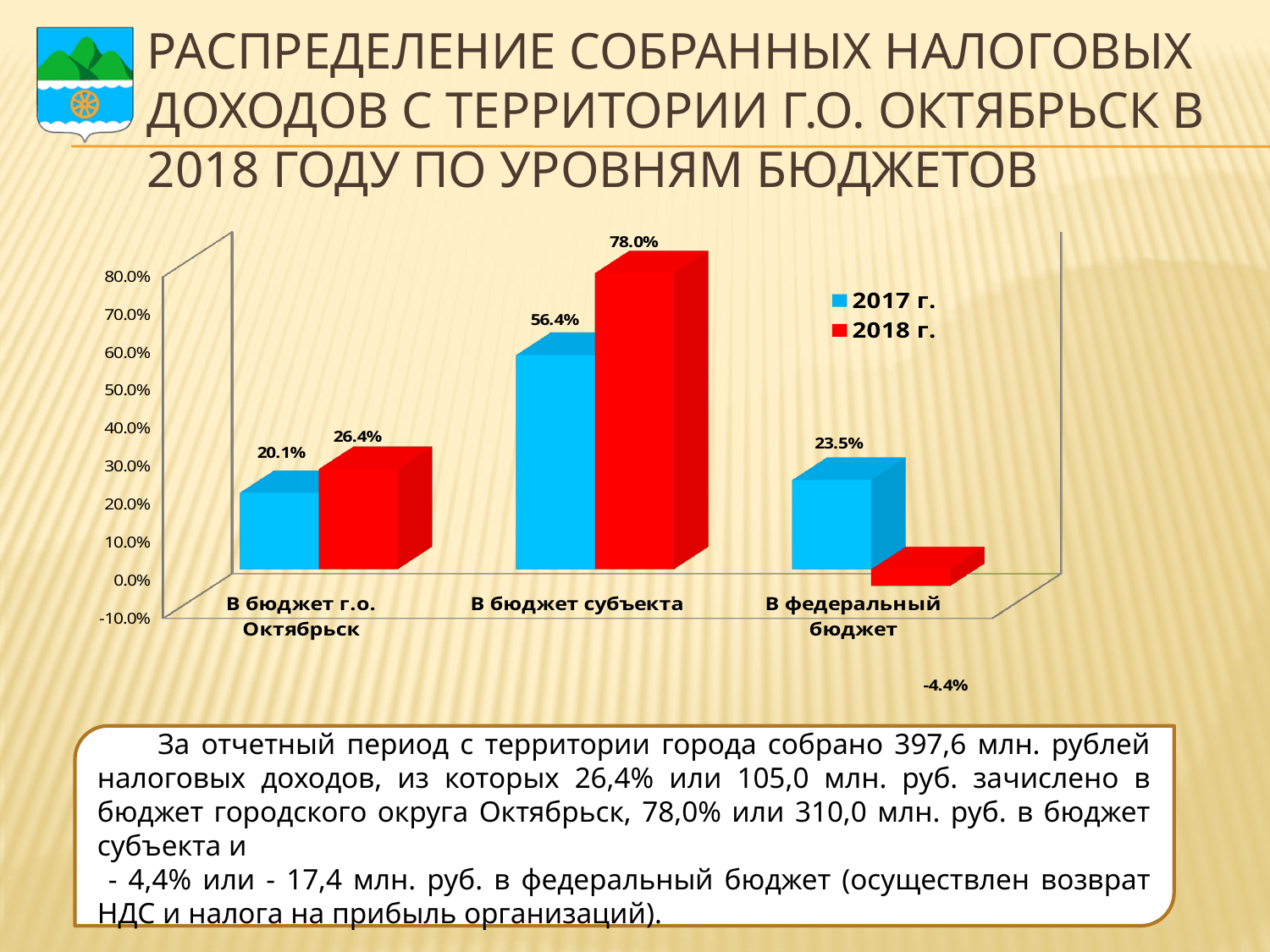
What is the value for 2017 г. in the category «В бюджет г.о. Октябрьск»? 20.1% What kind of chart is shown on the slide? Bar chart What is the value for 2017 г. in the category «В федеральный бюджет»? 23.5% What is the value for 2018 г. in the category «В бюджет субъекта»? 78.0% Which category has the highest value for 2018 г.? В бюджет субъекта What is the value for 2018 г. in the category «В федеральный бюджет»? -4.4% How many series does the legend list? 2 Which category has the lowest value for 2018 г.? В федеральный бюджет Which colour represents the series 2018 г. in the legend? Red What is the difference between the 2018 г. and 2017 г. values for «В бюджет субъекта»? 21.6% Which is larger for «В федеральный бюджет»: the 2017 г. value or the 2018 г. value? 2017 г. How many categories are shown on the x axis? 3